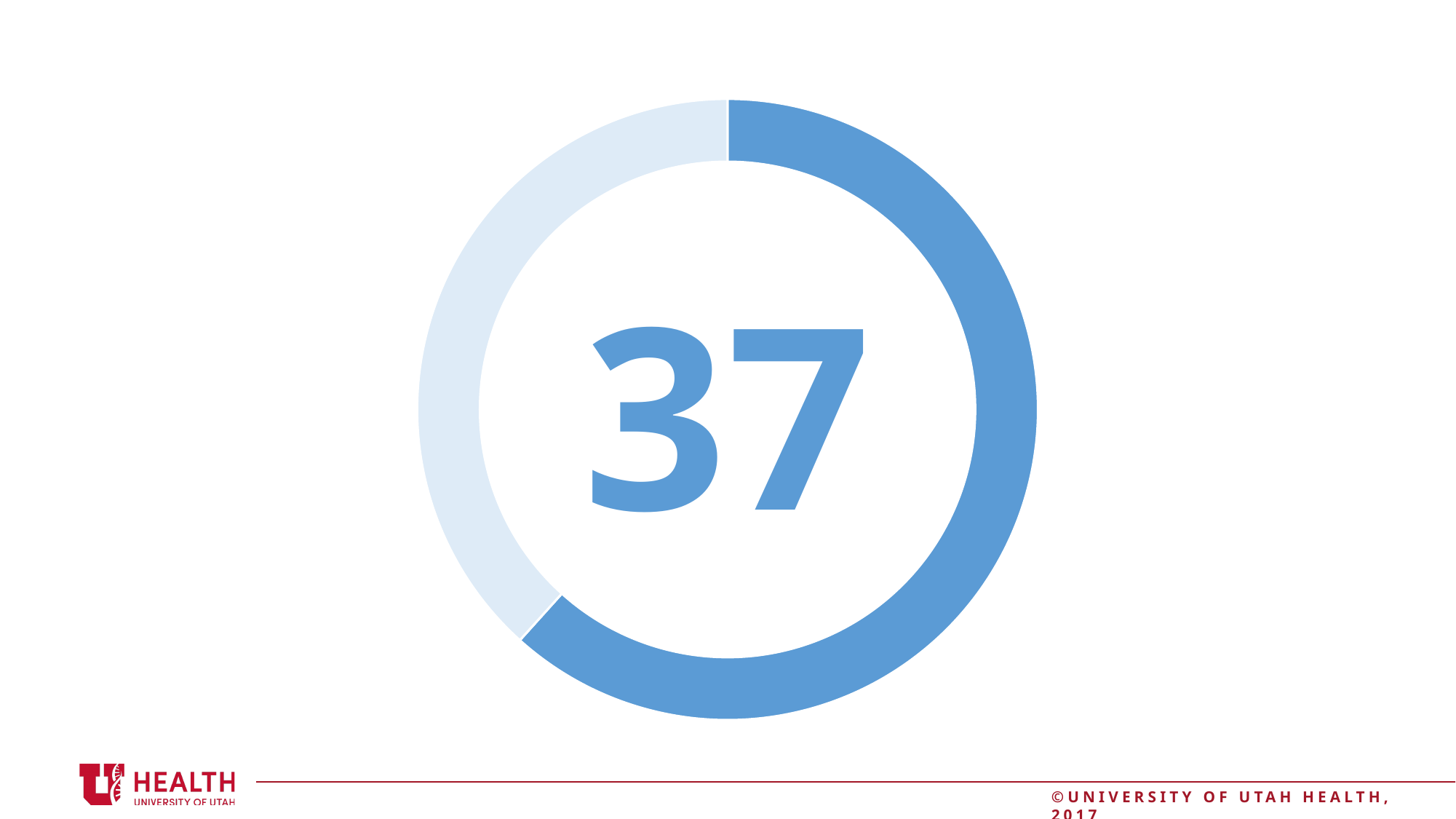
What colour is the larger segment of the doughnut chart? Dark blue What number is printed in the center of the doughnut chart? 37 How many segments does the doughnut chart have? 2 What kind of chart is shown on the slide? Doughnut chart Does the light blue segment cover more or less than half of the doughnut chart? Less Which segment of the doughnut chart is larger, the dark blue one or the light blue one? Dark blue Does the doughnut chart have a legend? No Does the dark blue segment cover more or less than half of the doughnut chart? More